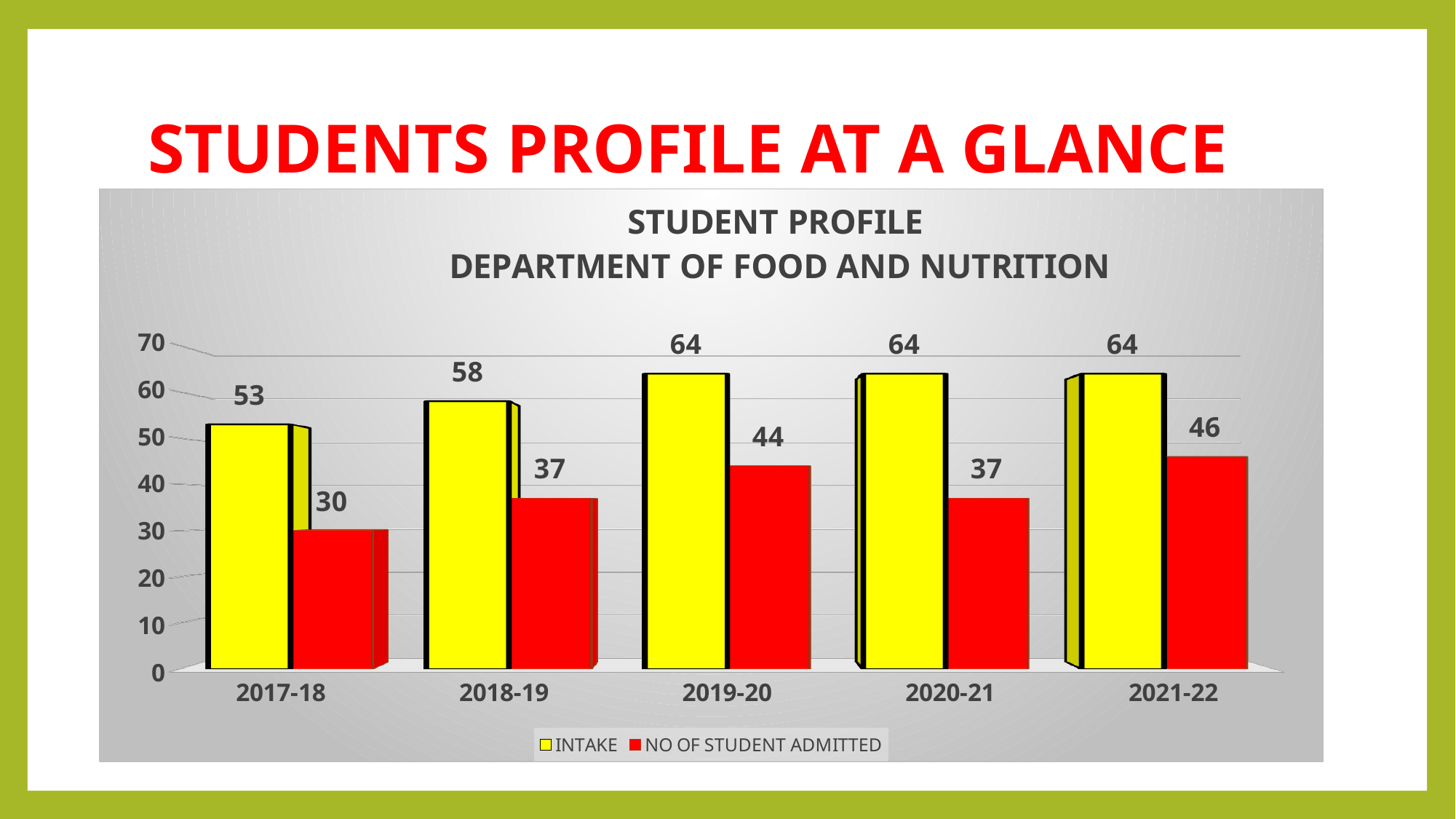
How many series does the legend list? 2 What kind of chart is shown on the slide? Bar chart Which year has the lowest NO OF STUDENT ADMITTED? 2017-18 Which is larger, the NO OF STUDENT ADMITTED in 2019-20 or in 2020-21? 2019-20 What is the NO OF STUDENT ADMITTED value for 2021-22? 46 Which year has the highest NO OF STUDENT ADMITTED? 2021-22 How many years are shown on the x axis? 5 Which year has the lowest INTAKE? 2017-18 What is the difference between INTAKE and NO OF STUDENT ADMITTED in 2021-22? 18 What is the INTAKE value for 2017-18? 53 What is the difference between INTAKE and NO OF STUDENT ADMITTED in 2018-19? 21 What is the NO OF STUDENT ADMITTED value for 2019-20? 44